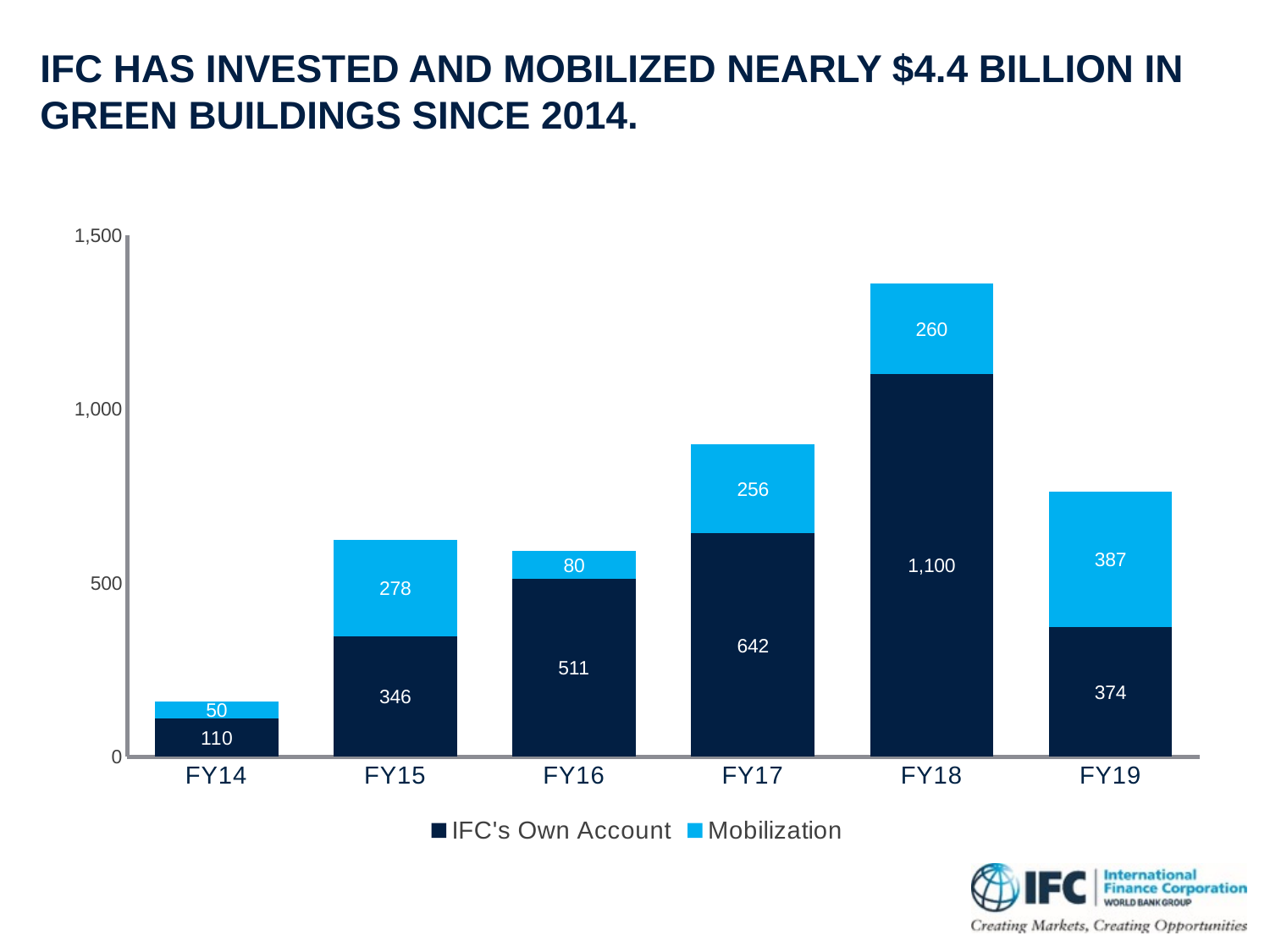
What is the Mobilization value for FY19? 387 What is the total of the stacked bar for FY17? 898 What kind of chart is shown on the slide? Stacked bar chart Which fiscal year has the highest IFC's Own Account value? FY18 What is the value of IFC's Own Account for FY16? 511 What is the value of IFC's Own Account for FY18? 1,100 Is the total stacked bar for FY18 greater or less than 1,000? greater How many series does the legend list? 2 How many fiscal years are shown on the x axis? 6 What is the difference between IFC's Own Account values for FY17 and FY15? 296 Which fiscal year has the lowest Mobilization value? FY14 Which is larger, the Mobilization value for FY15 or for FY17? FY15